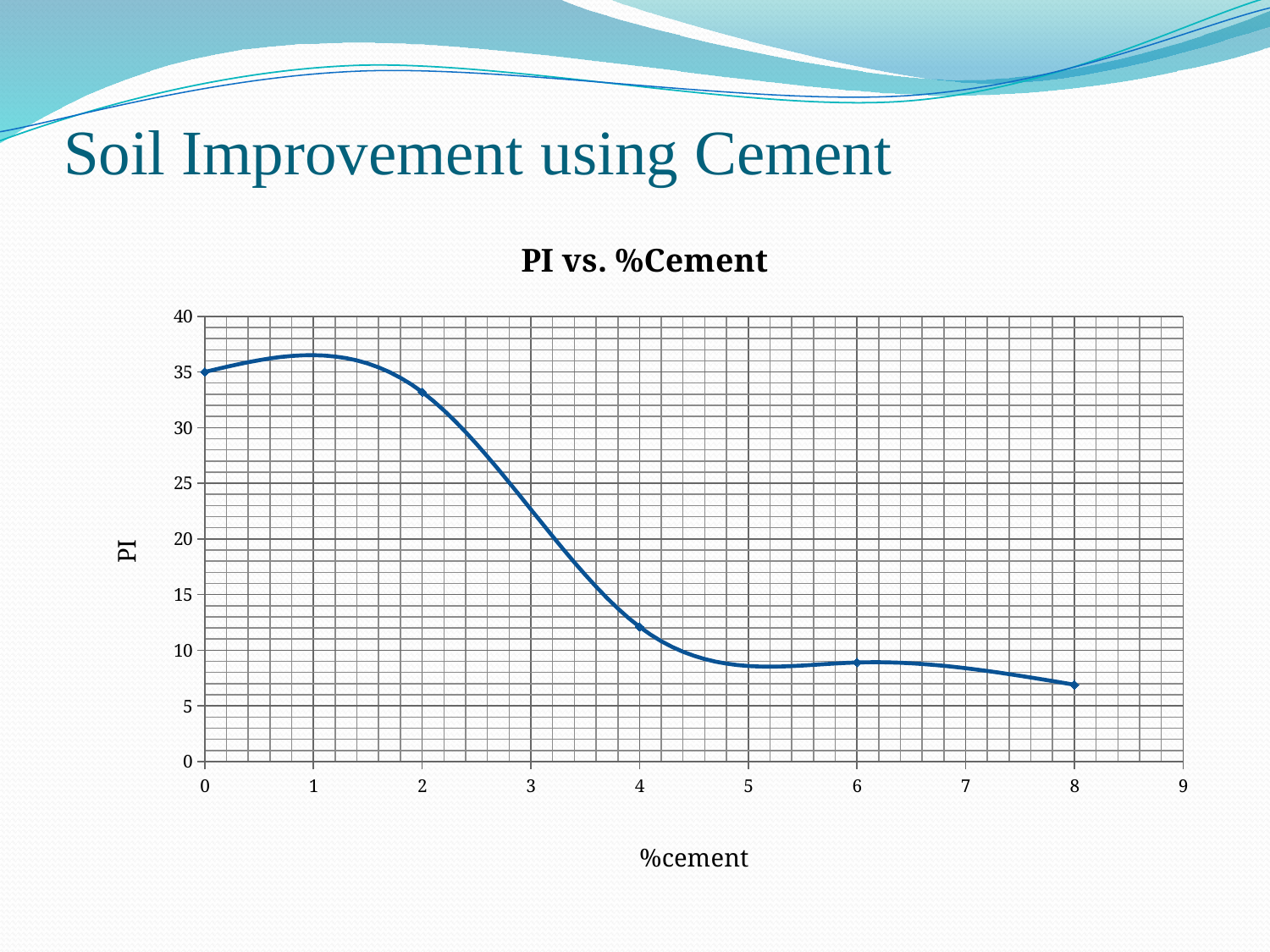
What is the title of the chart? PI vs. %Cement Is the PI value at 2 %cement greater or less than 30? greater Is the PI value at 6 %cement greater or less than 10? less What is the PI value at 0 %cement? 35 Does PI generally rise or fall as %cement increases? fall Which has a higher PI value: 2 %cement or 4 %cement? 2 %cement At which %cement value is PI highest? 0 What type of chart is shown on the slide? line chart What is the label of the x axis? %cement How many data points are plotted on the chart? 5 Is the PI value at 4 %cement greater or less than 15? less At which %cement value is PI lowest? 8